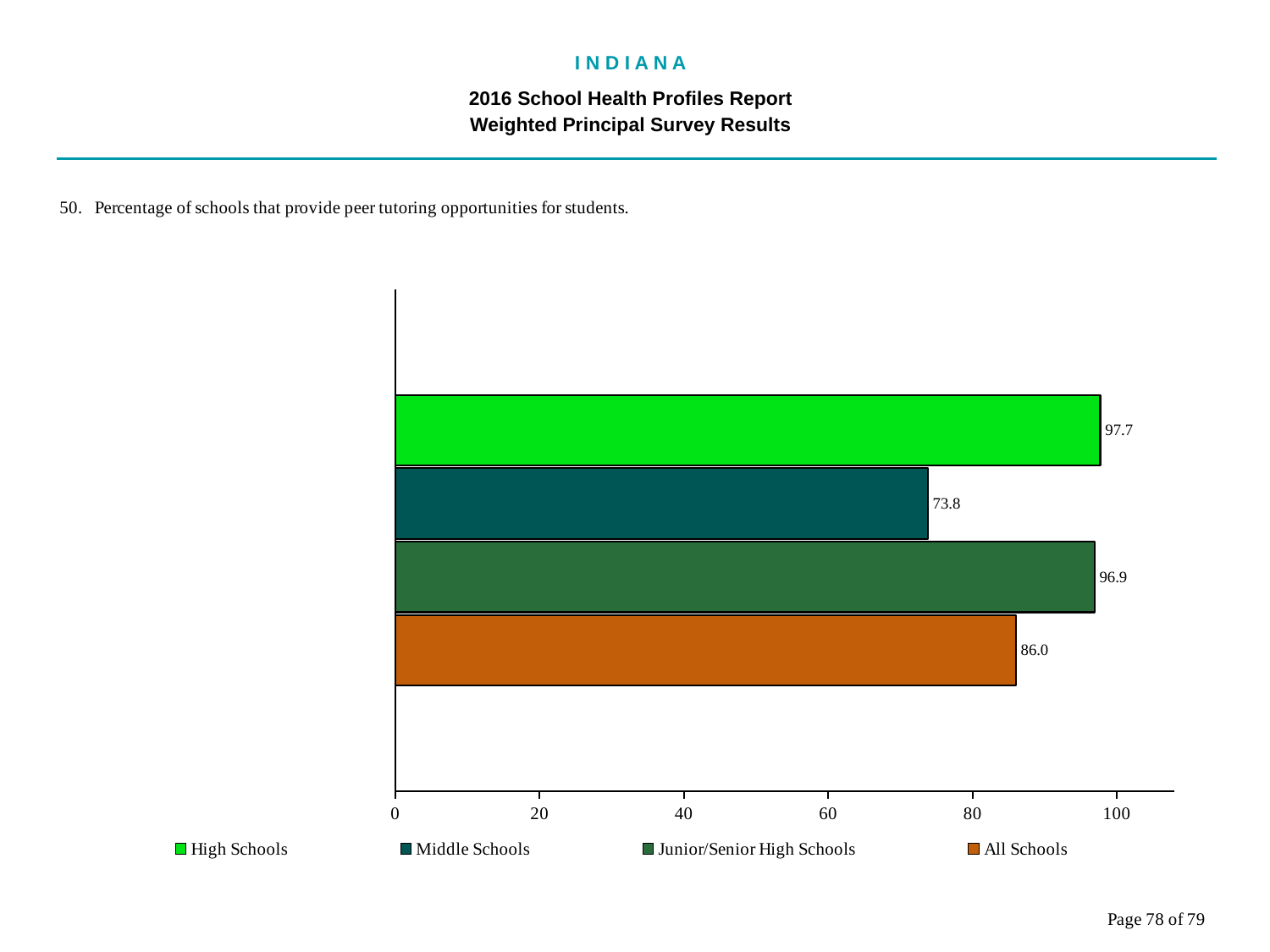
What is the value for Middle Schools? 73.8 What is the value for All Schools? 86.0 What kind of chart is shown on the slide? Bar chart What is the value for High Schools? 97.7 What colour is the bar for All Schools? Orange How many series does the legend list? 4 Which series has the highest value? High Schools What is the difference between the All Schools value and the Middle Schools value? 12.2 What is the value for Junior/Senior High Schools? 96.9 Which series has the lowest value? Middle Schools Which is larger, the value for All Schools or the value for Middle Schools? All Schools What is the difference between the High Schools value and the Middle Schools value? 23.9